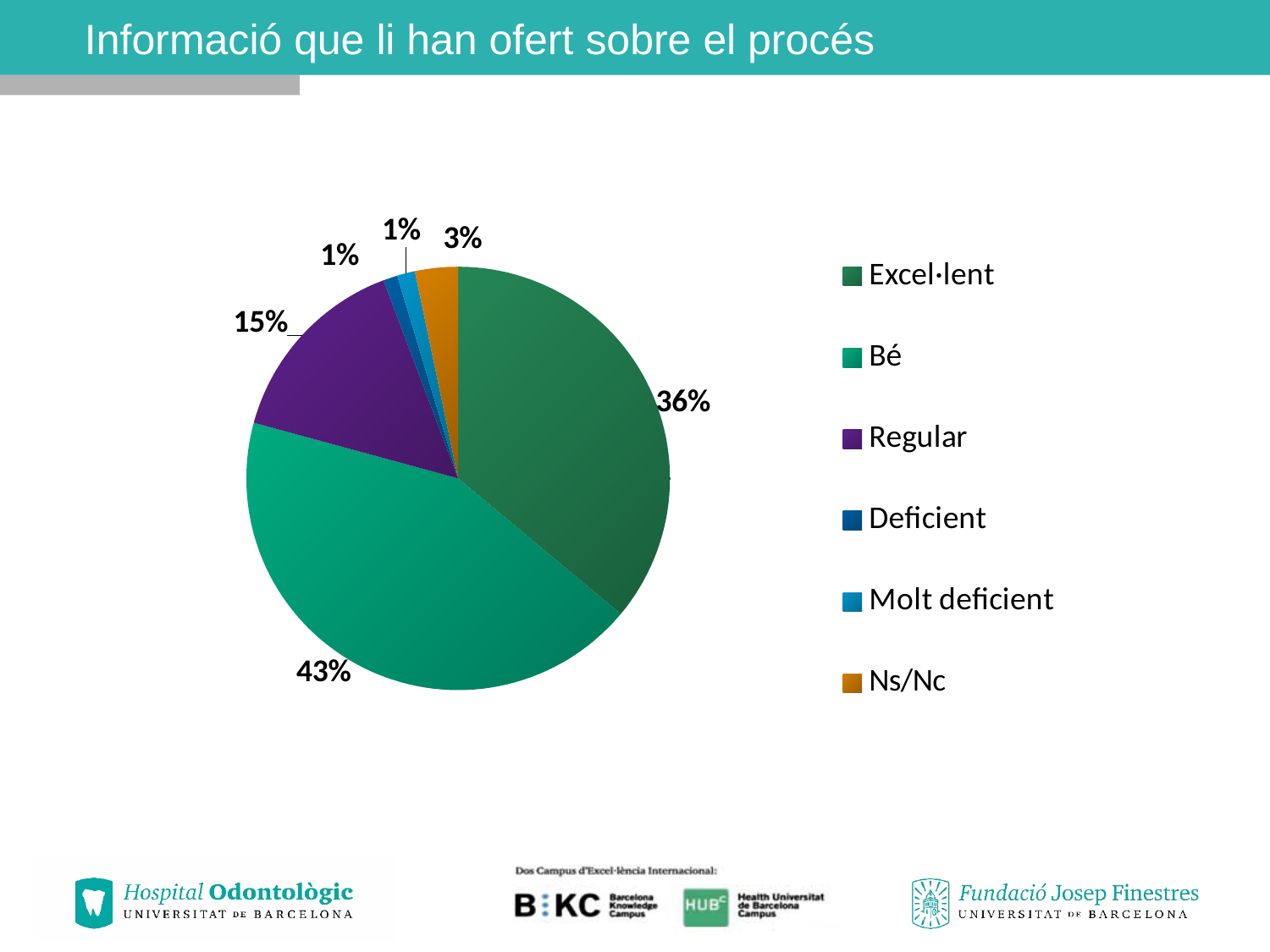
What share of the pie does Molt deficient represent? 1% How many categories does the legend list? 6 What share of the pie does Excel·lent represent? 36% What is the difference between the shares for Bé and Excel·lent? 7% What share of the pie does Regular represent? 15% What is the title of the slide containing the chart? Informació que li han ofert sobre el procés What colour is the slice for Regular? purple Which category has the largest slice of the pie? Bé What share of the pie does Bé represent? 43% What kind of chart is shown on the slide? pie chart Which is larger, the share for Regular or the share for Ns/Nc? Regular What share of the pie does Ns/Nc represent? 3%